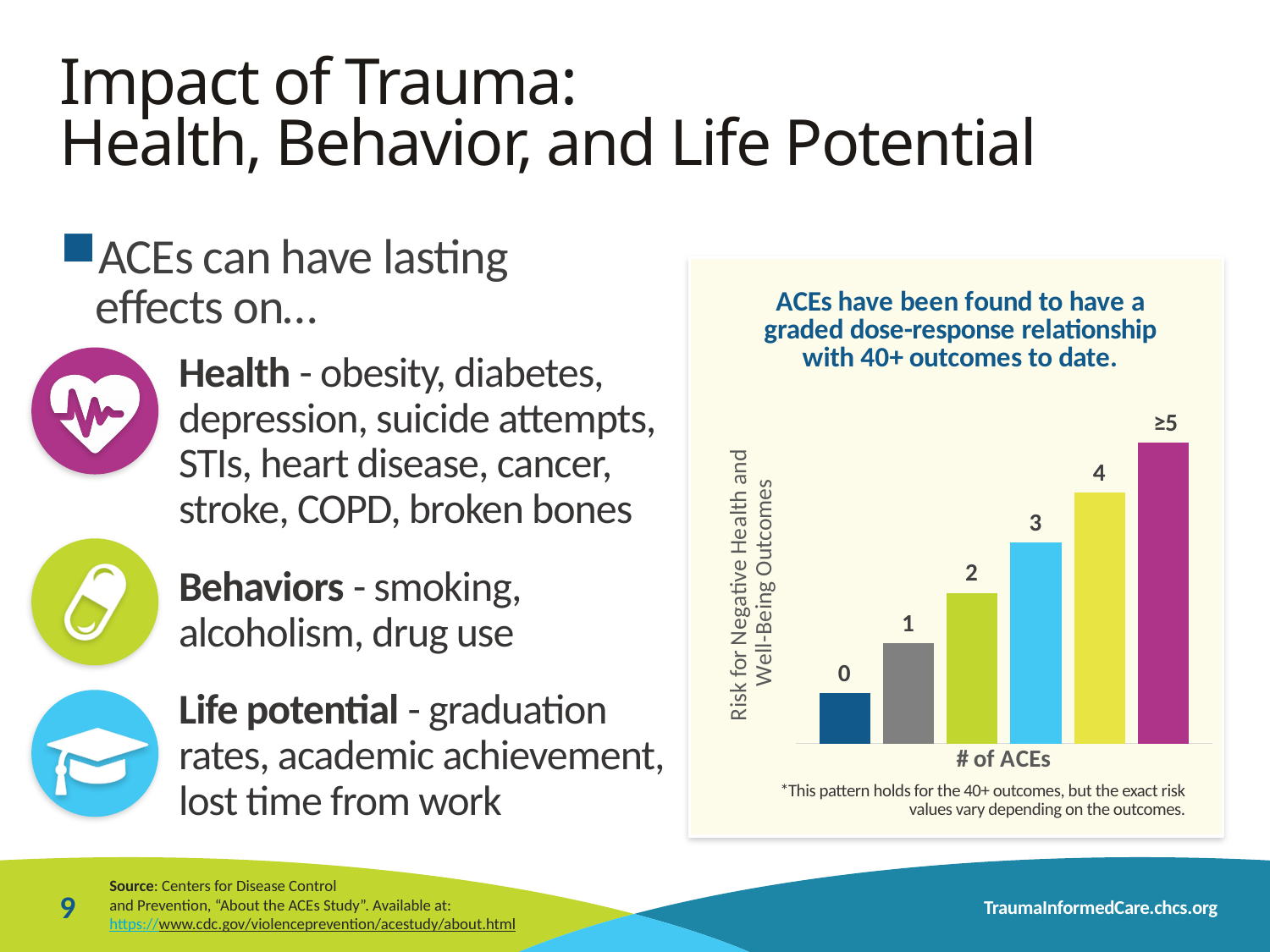
Which bar is taller, the one for 3 ACEs or the one for 1 ACE? 3 Which category has the shortest bar in the chart? 0 Which category has the tallest bar in the chart? ≥5 What is the label of the x axis of the chart? # of ACEs What is the label of the last (rightmost) category on the x axis? ≥5 What is the label of the y axis of the chart? Risk for Negative Health and Well-Being Outcomes How many bars does the chart show? 6 What kind of chart is shown on the slide? bar chart Do the bars rise or fall as the number of ACEs increases along the x axis? rise Which bar is taller, the one for 2 ACEs or the one for 4 ACEs? 4